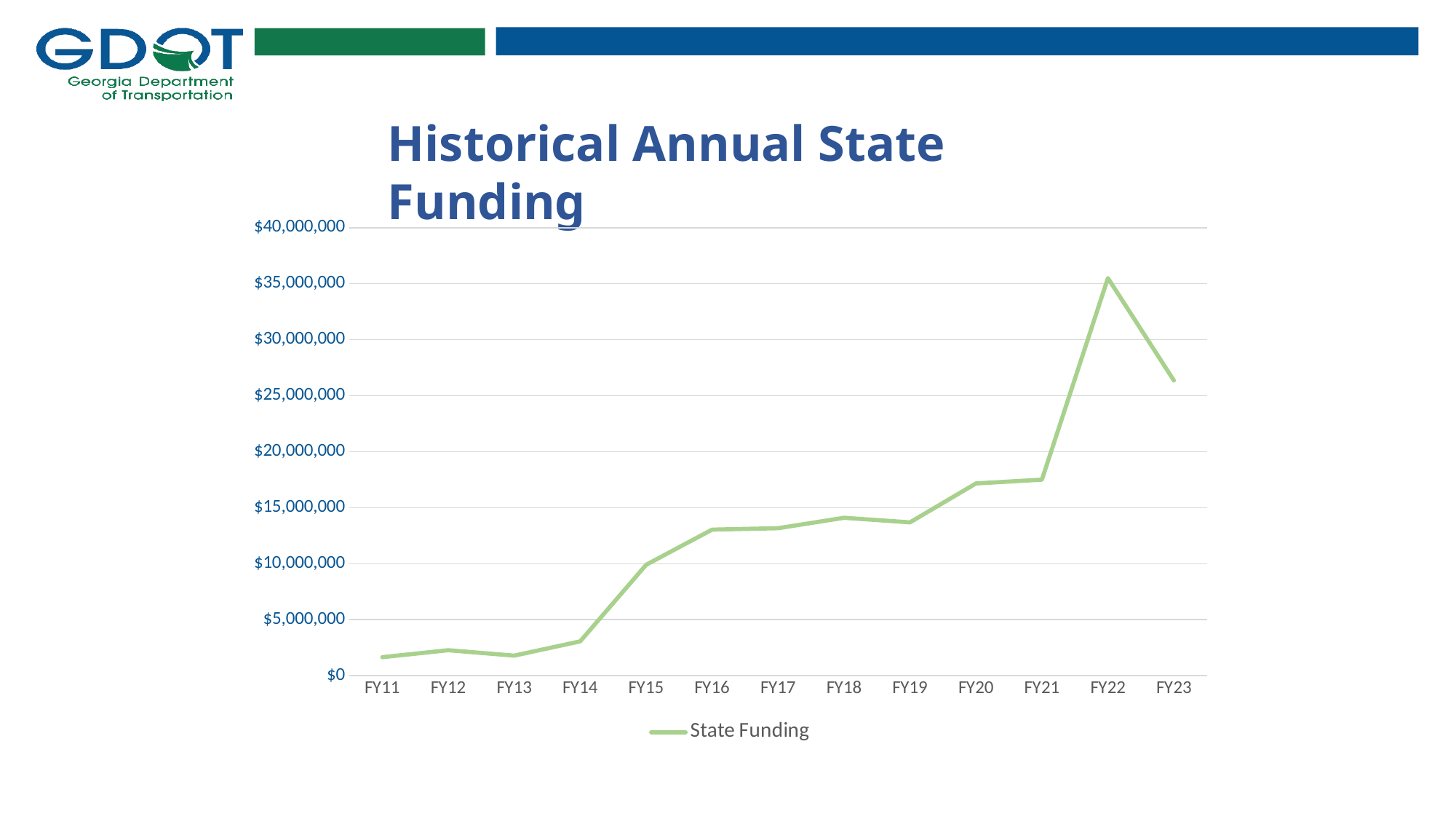
Which is larger, the state funding for FY14 or FY15? FY15 Which fiscal year has the highest state funding? FY22 What kind of chart is shown on the slide? line chart Is the value for FY22 greater or less than $30,000,000? greater How many series does the legend list? 1 Is the value for FY14 greater or less than $5,000,000? less What is the title of the chart? Historical Annual State Funding Does state funding rise or fall from FY22 to FY23? fall How many fiscal years are plotted on the x axis? 13 Is the value for FY23 greater or less than $25,000,000? greater Which is larger, the state funding for FY22 or FY23? FY22